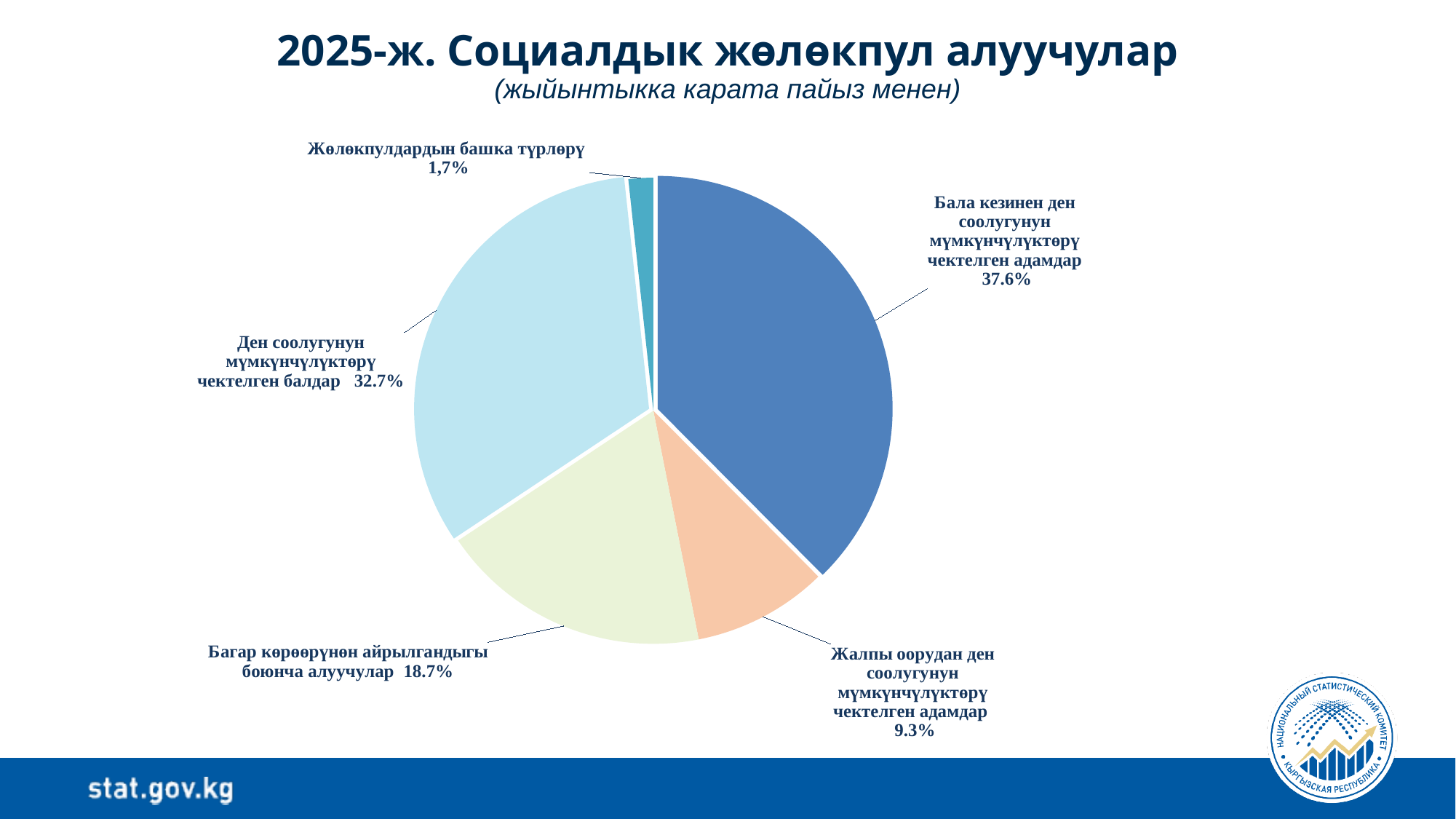
How many slices does the pie chart have? 5 What share of the pie is labelled "Багар көрөөрүнөн айрылгандыгы боюнча алуучулар"? 18.7% What type of chart is shown on the slide? pie chart By how many percentage points does the slice for "Бала кезинен ден соолугунун мүмкүнчүлүктөрү чектелген адамдар" exceed the slice for "Ден соолугунун мүмкүнчүлүктөрү чектелген балдар"? 4.9 Which is larger: the slice for "Багар көрөөрүнөн айрылгандыгы боюнча алуучулар" or the slice for "Жалпы оорудан ден соолугунун мүмкүнчүлүктөрү чектелген адамдар"? Багар көрөөрүнөн айрылгандыгы боюнча алуучулар What share of the pie is labelled "Ден соолугунун мүмкүнчүлүктөрү чектелген балдар"? 32.7% Which category has the smallest slice of the pie? Жөлөкпулдардын башка түрлөрү What is the title of the chart on the slide? 2025-ж. Социалдык жөлөкпул алуучулар What share of the pie is labelled "Жалпы оорудан ден соолугунун мүмкүнчүлүктөрү чектелген адамдар"? 9.3% What share of the pie is labelled "Жөлөкпулдардын башка түрлөрү"? 1,7% Which category has the largest slice of the pie? Бала кезинен ден соолугунун мүмкүнчүлүктөрү чектелген адамдар What share of the pie is labelled "Бала кезинен ден соолугунун мүмкүнчүлүктөрү чектелген адамдар"? 37.6%